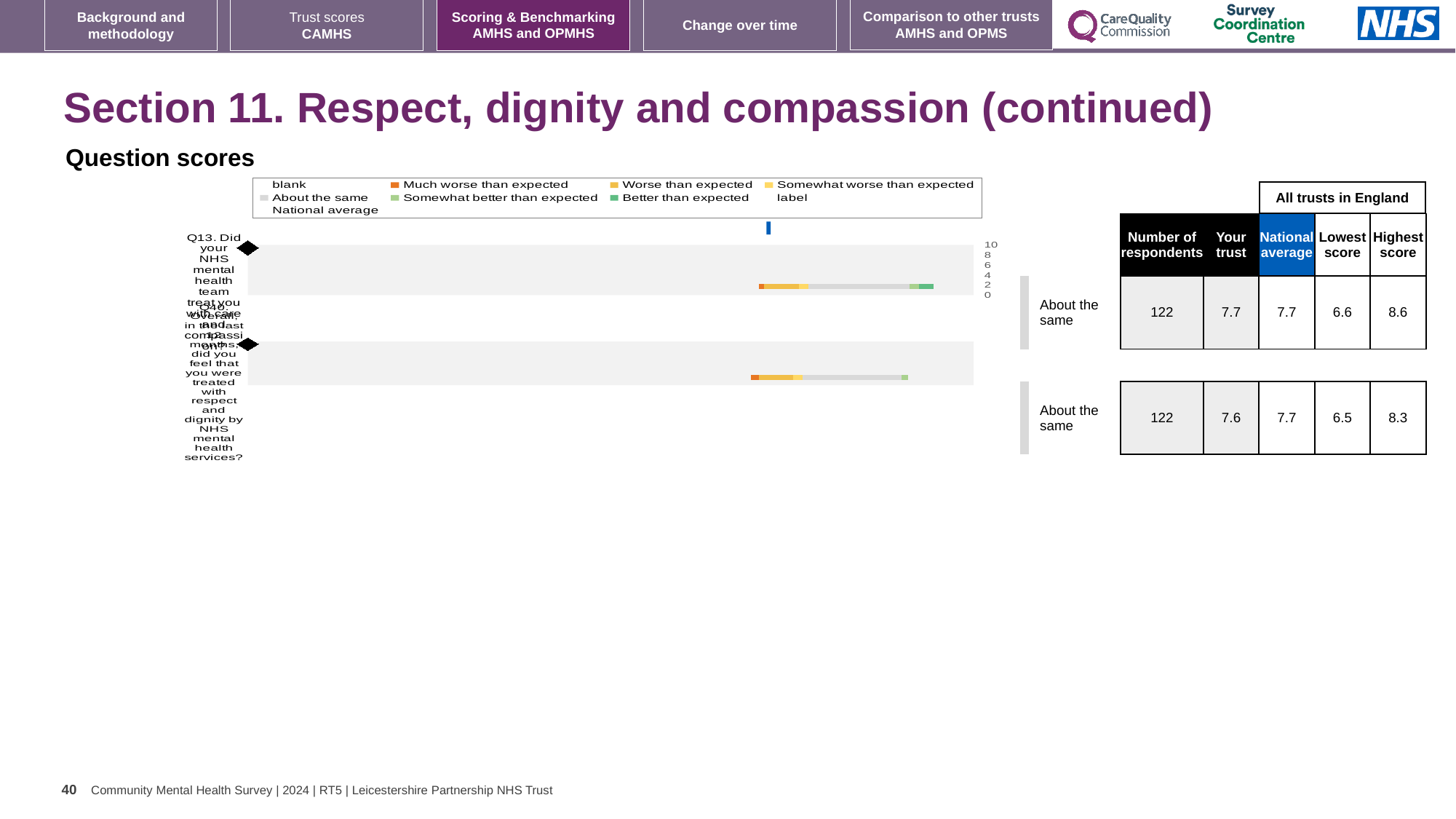
In the chart legend, what does the blue marker represent? National average According to the table beside the chart, what is the highest score across all trusts in England for Q14? 8.3 What kind of chart is shown under 'Question scores'? bar chart How many questions are plotted as rows in the chart? 2 What is the highest tick value shown on the chart's score axis? 10 Which question has the higher 'Your trust' score in the table beside the chart, Q13 or Q14? Q13 What is the difference between the highest score and the lowest score for Q13 in the table beside the chart? 2.0 According to the table beside the chart, what is the 'Your trust' score for Q14? 7.6 According to the table beside the chart, what is the 'Your trust' score for Q13? 7.7 According to the table beside the chart, how many respondents answered Q13? 122 What benchmark category is shown next to the chart for both Q13 and Q14? About the same According to the table beside the chart, what is the lowest score across all trusts in England for Q13? 6.6